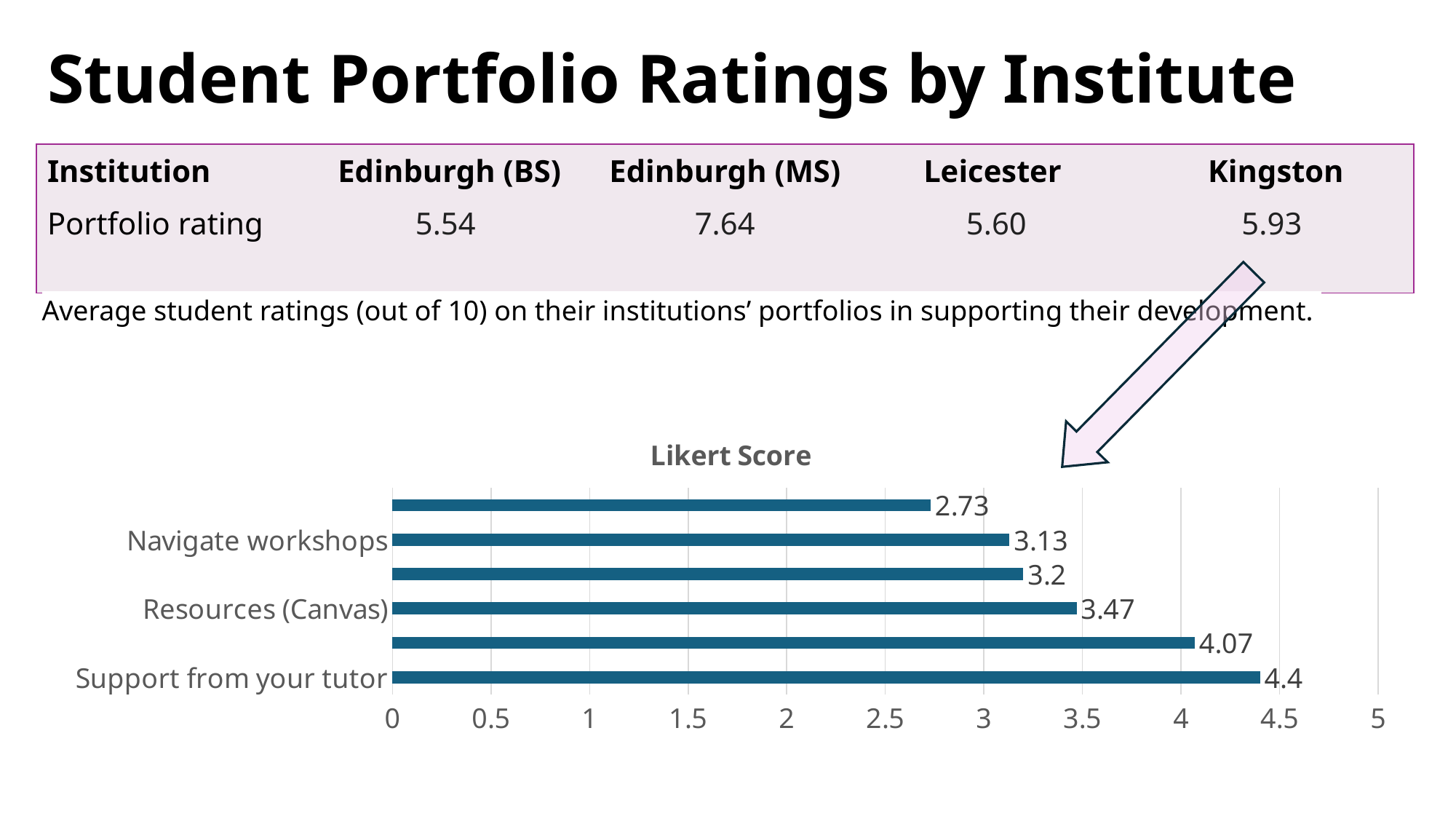
What is the difference between the Likert scores for Support from your tutor and Navigate workshops? 1.27 What is the lowest value shown on the chart? 2.73 What is the Likert score for Support from your tutor? 4.4 What kind of chart is shown on the slide? bar chart What is the title of the chart? Likert Score Which labelled category has the highest Likert score? Support from your tutor What is the Likert score for Navigate workshops? 3.13 Is the value for Support from your tutor greater or less than 4? greater What is the highest value shown on the chart? 4.4 What is the Likert score for Resources (Canvas)? 3.47 How many bars are plotted on the chart? 6 Which has a higher Likert score, Resources (Canvas) or Navigate workshops? Resources (Canvas)